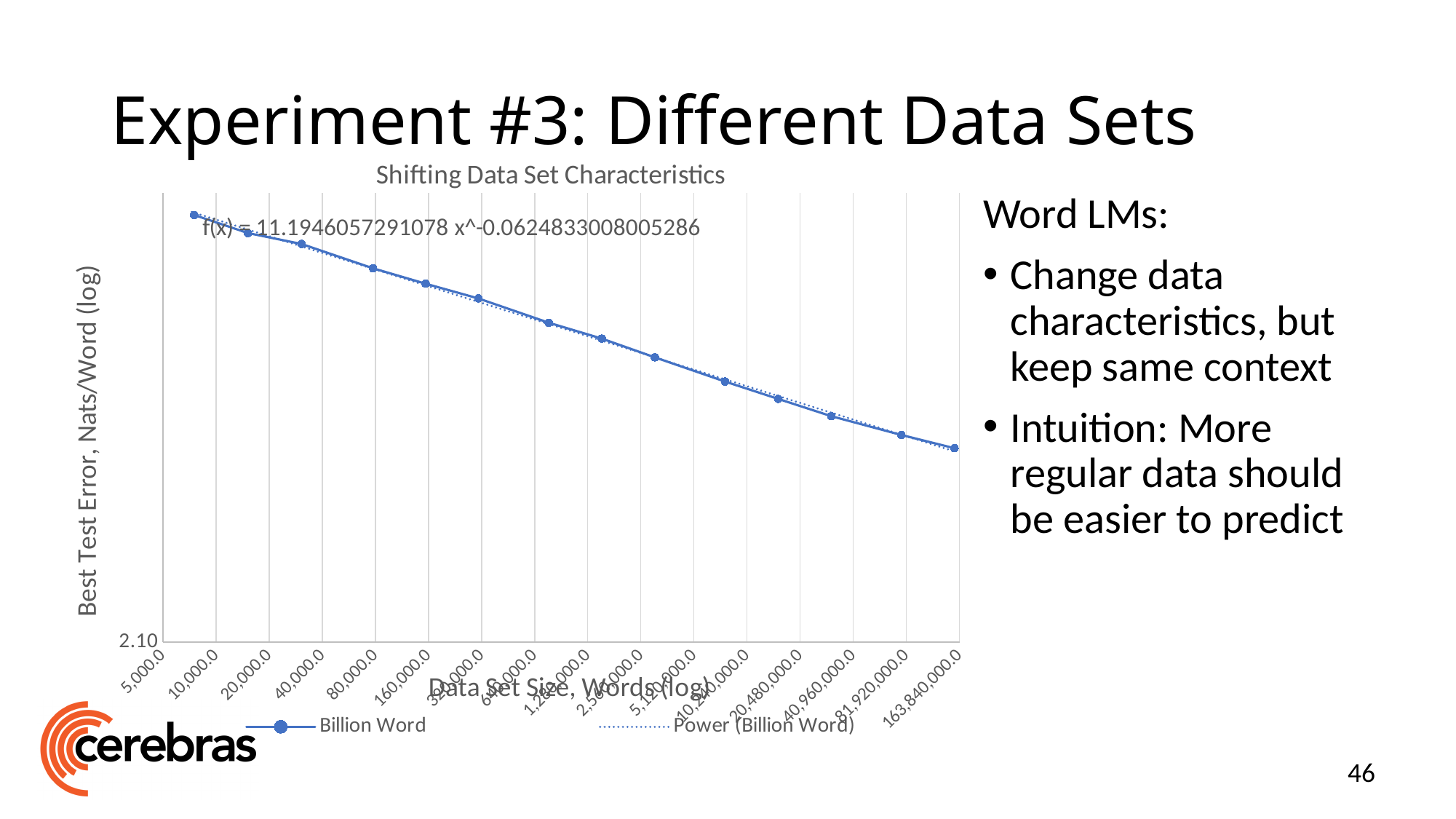
Does the Billion Word best test error rise or fall as data set size increases along the x axis? fall What is the coefficient in the fitted power-law equation f(x) shown on the chart? 11.1946057291078 What is the exponent in the fitted power-law equation shown on the chart? -0.0624833008005286 What is the label of the y axis of the chart? Best Test Error, Nats/Word (log) What are the two entries in the chart legend? Billion Word; Power (Billion Word) What kind of chart is shown on the slide? line chart Is the Billion Word best test error at a data set size of 163,840,000.0 greater or less than 2.10? greater What is the title of the chart? Shifting Data Set Characteristics How many series does the chart legend list? 2 Which has the larger Billion Word best test error: a data set size of 10,000.0 or 163,840,000.0? 10,000.0